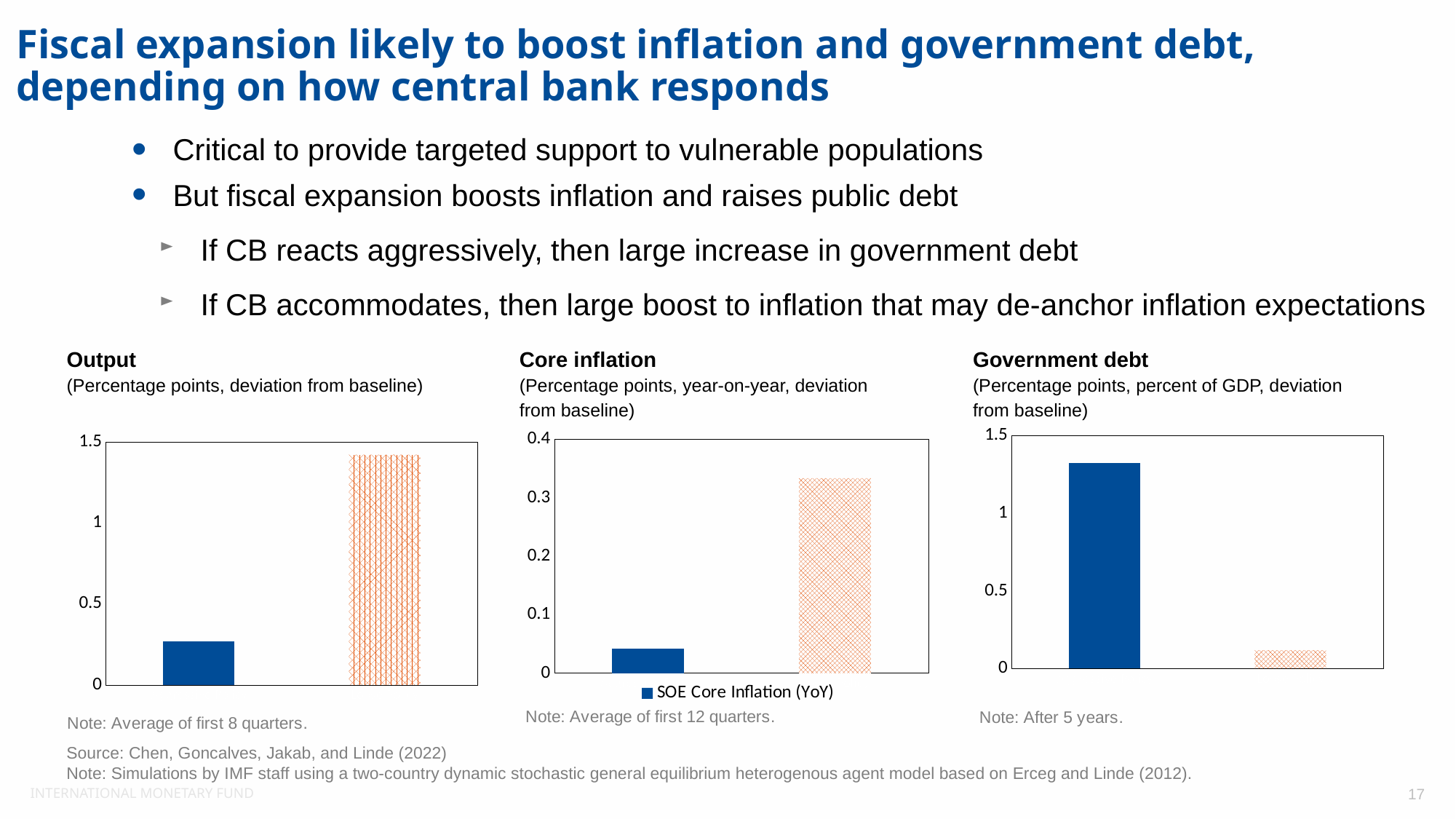
In the Core inflation chart, is the value of the hatched orange bar greater or less than 0.3? greater In the Core inflation chart, what is the legend entry? SOE Core Inflation (YoY) In the Government debt chart, is the value of the solid blue bar greater or less than 1? greater In the Output chart, is the value of the hatched orange bar greater or less than 1? greater In the Output chart, how many bars are plotted? 2 What kind of chart is the Output chart? bar chart In the Government debt chart, which bar is taller, the solid blue bar or the hatched orange bar? the solid blue bar In the Core inflation chart, how many entries does the legend list? 1 In the Output chart, which bar is taller, the solid blue bar or the hatched orange bar? the hatched orange bar